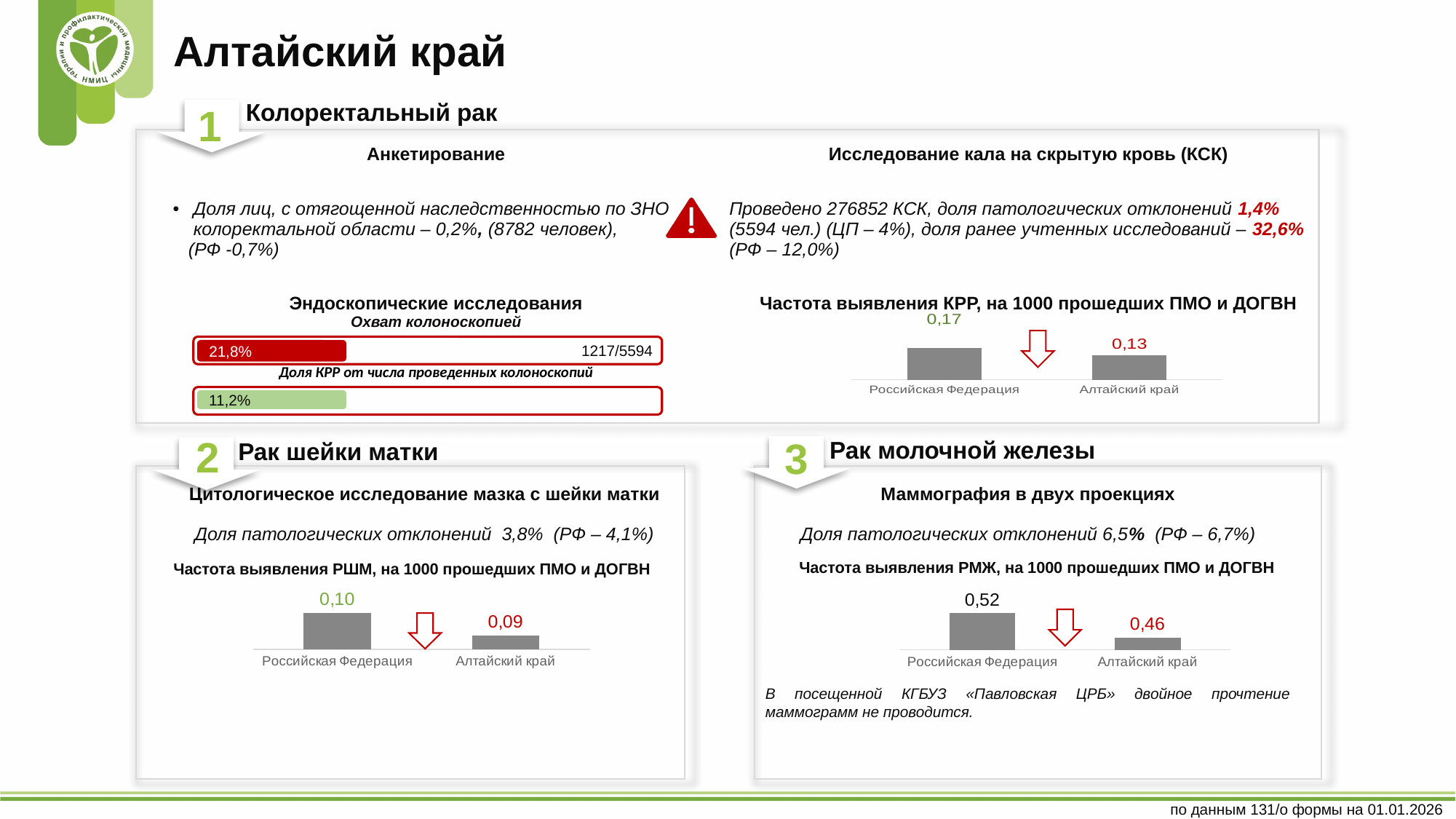
What kind of chart is 'Частота выявления КРР, на 1000 прошедших ПМО и ДОГВН'? Bar chart In the chart 'Частота выявления КРР, на 1000 прошедших ПМО и ДОГВН', what is the difference between Российская Федерация and Алтайский край? 0,04 In the chart 'Частота выявления РШМ, на 1000 прошедших ПМО и ДОГВН', what is the value for Российская Федерация? 0,10 How many categories are shown in the chart 'Частота выявления РМЖ, на 1000 прошедших ПМО и ДОГВН'? 2 In the chart 'Частота выявления КРР, на 1000 прошедших ПМО и ДОГВН', what is the value for Российская Федерация? 0,17 In the chart 'Частота выявления РМЖ, на 1000 прошедших ПМО и ДОГВН', what is the value for Российская Федерация? 0,52 In the chart 'Частота выявления РМЖ, на 1000 прошедших ПМО и ДОГВН', what is the difference between Российская Федерация and Алтайский край? 0,06 In the chart 'Частота выявления РМЖ, на 1000 прошедших ПМО и ДОГВН', what is the value for Алтайский край? 0,46 In the chart 'Частота выявления РШМ, на 1000 прошедших ПМО и ДОГВН', what is the value for Алтайский край? 0,09 In the chart 'Частота выявления КРР, на 1000 прошедших ПМО и ДОГВН', what is the value for Алтайский край? 0,13 In the chart 'Частота выявления КРР, на 1000 прошедших ПМО и ДОГВН', which category has the higher value? Российская Федерация In the chart 'Частота выявления РШМ, на 1000 прошедших ПМО и ДОГВН', which category has the lower value? Алтайский край